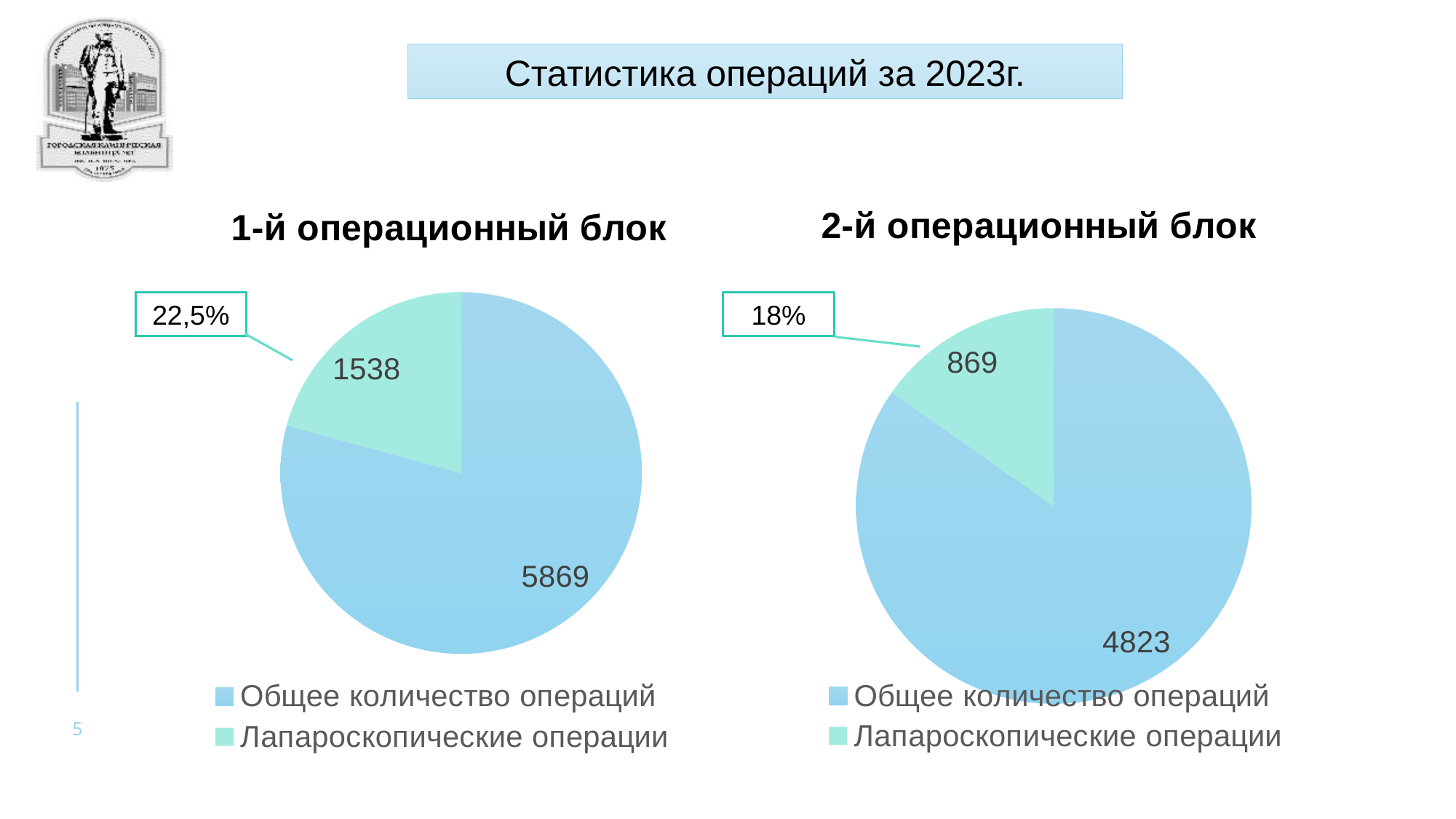
In the 1-й операционный блок chart, which category has the largest slice? Общее количество операций In the 1-й операционный блок chart, what is the value for Лапароскопические операции? 1538 How many legend entries does the 2-й операционный блок chart have? 2 In the 2-й операционный блок chart, what is the value for Лапароскопические операции? 869 Which is larger: Лапароскопические операции in the 1-й операционный блок chart or in the 2-й операционный блок chart? 1-й операционный блок In the 2-й операционный блок chart, what is the difference between Общее количество операций and Лапароскопические операции? 3954 In the 2-й операционный блок chart, which category has the smallest slice? Лапароскопические операции In the 1-й операционный блок chart, what is the difference between Общее количество операций and Лапароскопические операции? 4331 What type of chart is used for the 1-й операционный блок? pie chart What percentage is shown in the callout label on the 2-й операционный блок chart? 18% In the 2-й операционный блок chart, what is the value for Общее количество операций? 4823 In the 1-й операционный блок chart, what is the value for Общее количество операций? 5869